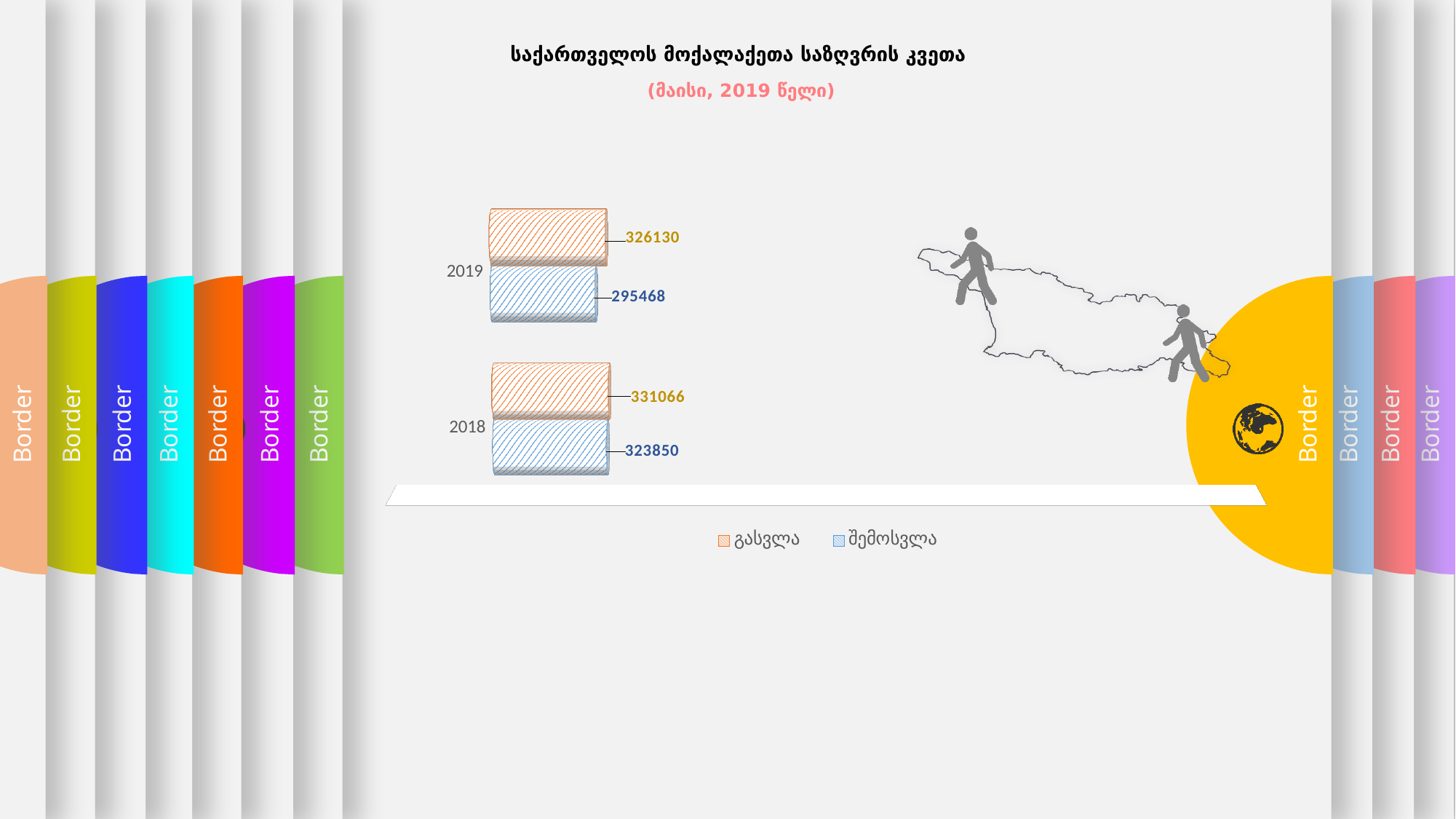
What is the value of შემოსვლა for 2018? 323850 What is the difference between გასვლა and შემოსვლა in 2019? 30662 Which year has the higher value for შემოსვლა? 2018 What is the difference between გასვლა in 2018 and გასვლა in 2019? 4936 How many series does the legend list? 2 How many years are shown on the chart? 2 What is the value of გასვლა for 2018? 331066 Which is larger in 2018, გასვლა or შემოსვლა? გასვლა What kind of chart is shown on the slide? bar chart What is the value of შემოსვლა for 2019? 295468 Which year has the lower value for გასვლა? 2019 What is the value of გასვლა for 2019? 326130